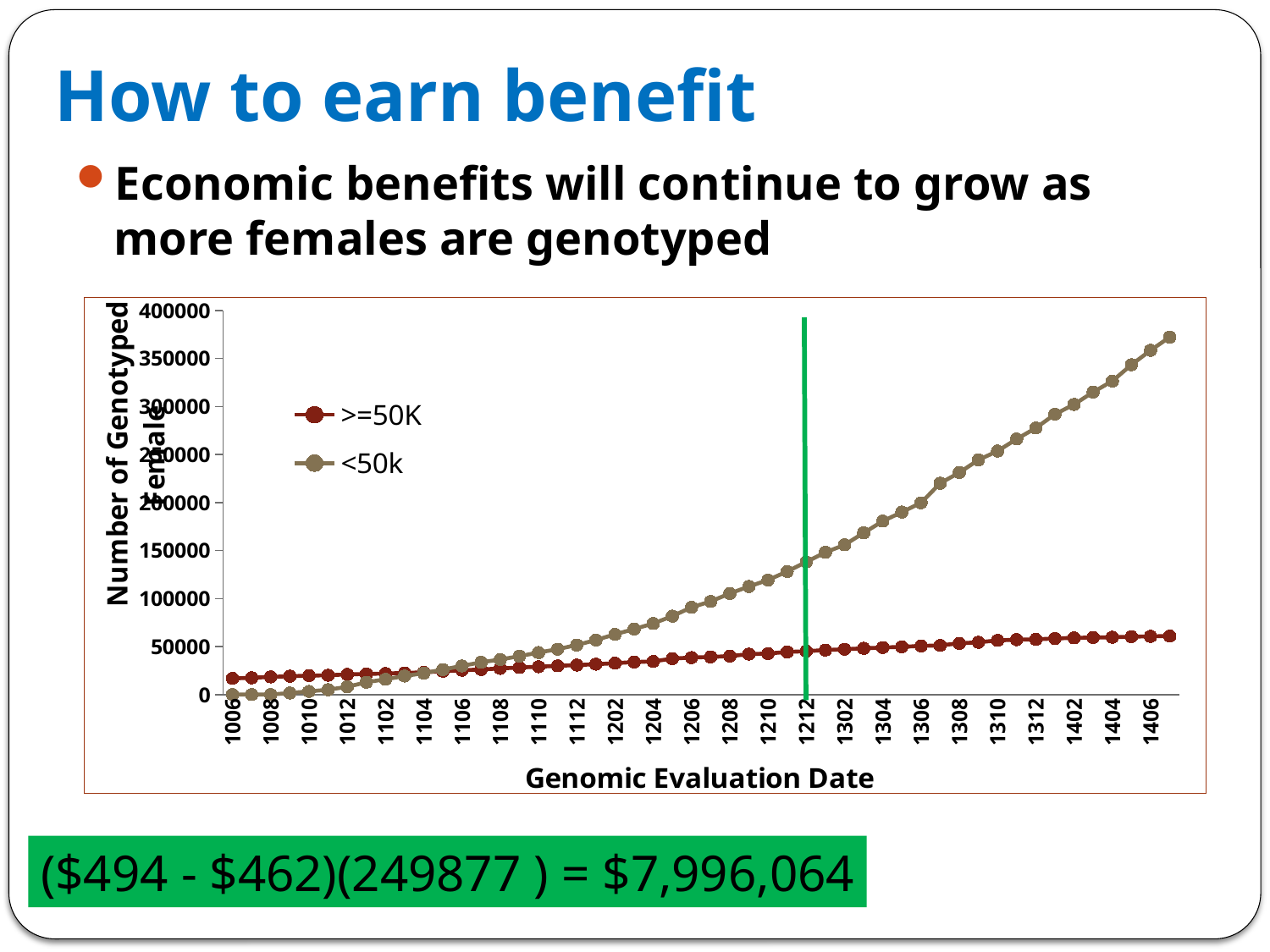
At 1006, which series has the larger value, >=50K or <50k? >=50K Is the value of the >=50K series at 1006 greater or less than 50000? less Is the value of the <50k series at 1212 greater or less than 100000? greater Is the value of the <50k series at 1006 greater or less than 50000? less At 1406, which series has the larger value, >=50K or <50k? <50k How many series does the chart's legend list? 2 What are the two series named in the chart's legend? >=50K and <50k What is the title of the chart's x axis? Genomic Evaluation Date Does the <50k series rise or fall as the genomic evaluation date increases? rise What kind of chart is shown on the slide? line chart Does the >=50K series rise or fall along the x axis? rise